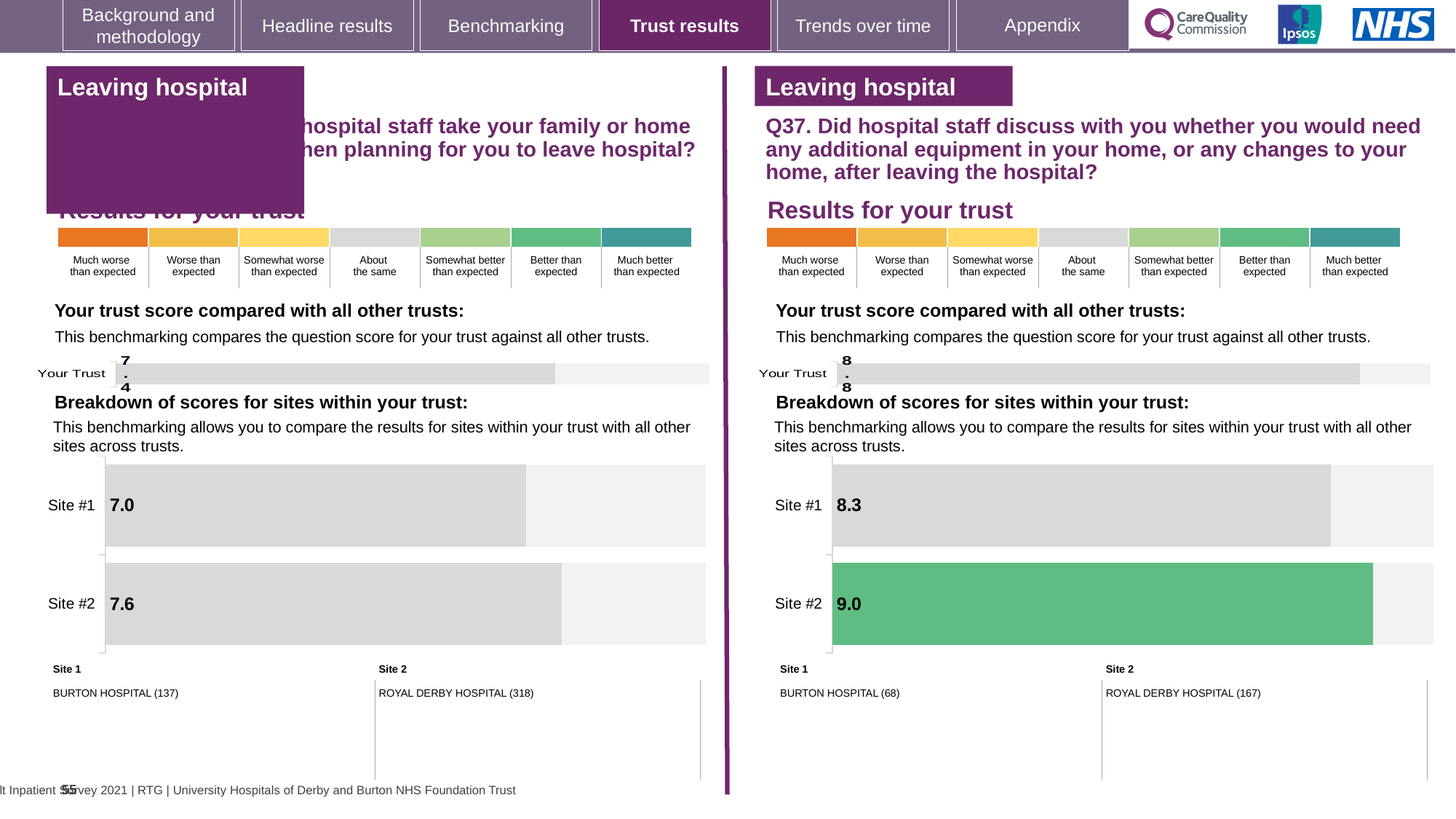
On the left-hand site breakdown chart, what is the score for Site #2? 7.6 On the left-hand site breakdown chart, what is the difference between the Site #2 and Site #1 scores? 0.6 On the right-hand 'Your trust score compared with all other trusts' chart (Q37), what is the score shown for Your Trust? 8.8 On the right-hand chart (Q37), what is the score for Site #2? 9.0 What type of chart is used for the site breakdown on the right-hand side (Q37)? Bar chart On the right-hand chart (Q37), what is the score for Site #1? 8.3 On the right-hand site breakdown chart (Q37), which site has the higher score? Site #2 On the right-hand site breakdown chart (Q37), what is the difference between the Site #2 and Site #1 scores? 0.7 On the left-hand site breakdown chart, what is the score for Site #1? 7.0 On the left-hand site breakdown chart, which site has the lower score? Site #1 How many sites are shown in the right-hand site breakdown chart (Q37)? 2 On the left-hand 'Your trust score compared with all other trusts' chart, what is the score shown for Your Trust? 7.4